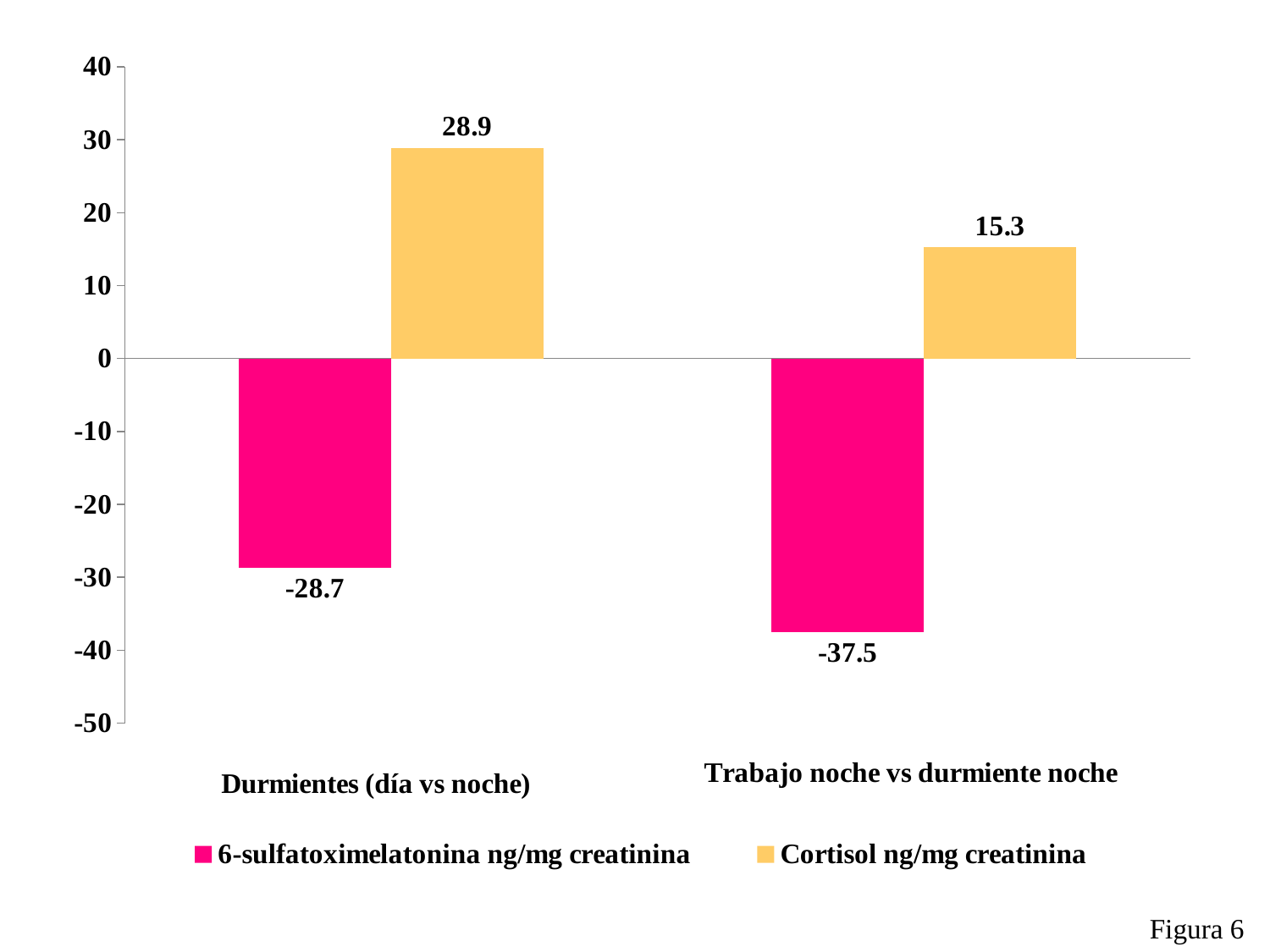
Which category has the higher Cortisol ng/mg creatinina value? Durmientes (día vs noche) What is the difference between the Cortisol ng/mg creatinina values for Durmientes (día vs noche) and Trabajo noche vs durmiente noche? 13.6 How many series does the legend list? 2 How many categories are shown on the x axis? 2 What is the value of 6-sulfatoximelatonina ng/mg creatinina for Trabajo noche vs durmiente noche? -37.5 Is the 6-sulfatoximelatonina ng/mg creatinina value for Trabajo noche vs durmiente noche greater or less than -30? less What is the value of Cortisol ng/mg creatinina for Durmientes (día vs noche)? 28.9 What is the value of Cortisol ng/mg creatinina for Trabajo noche vs durmiente noche? 15.3 Is the Cortisol ng/mg creatinina value for Durmientes (día vs noche) larger than the Cortisol value for Trabajo noche vs durmiente noche? Yes What kind of chart is shown on the slide? Bar chart Which category has the lowest 6-sulfatoximelatonina ng/mg creatinina value? Trabajo noche vs durmiente noche What is the value of 6-sulfatoximelatonina ng/mg creatinina for Durmientes (día vs noche)? -28.7